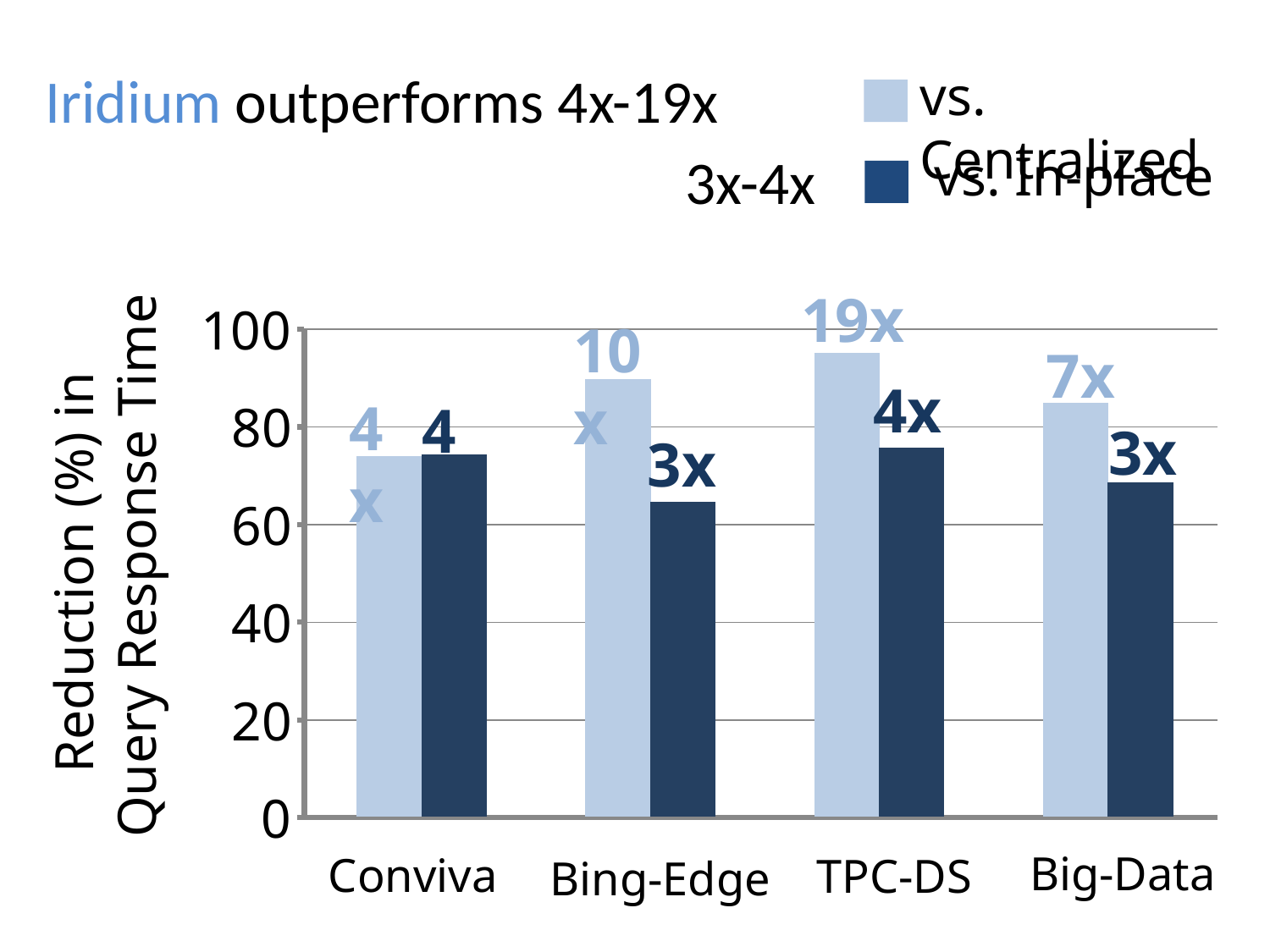
What speedup factor is labelled on the vs. In-place bar for Bing-Edge? 3x What kind of chart is shown on the slide? bar chart How many categories are shown on the x axis of the chart? 4 Which category has the highest vs. Centralized bar? TPC-DS What speedup factor is labelled on the vs. Centralized bar for TPC-DS? 19x What speedup factor is labelled on the vs. Centralized bar for Big-Data? 7x Is the vs. Centralized value for Conviva greater or less than 80? less Which category has the lowest vs. Centralized bar? Conviva What is the y-axis title of the chart? Reduction (%) in Query Response Time What are the two series named in the legend? vs. Centralized and vs. In-place For Bing-Edge, which bar is larger: vs. Centralized or vs. In-place? vs. Centralized How many series does the chart's legend list? 2